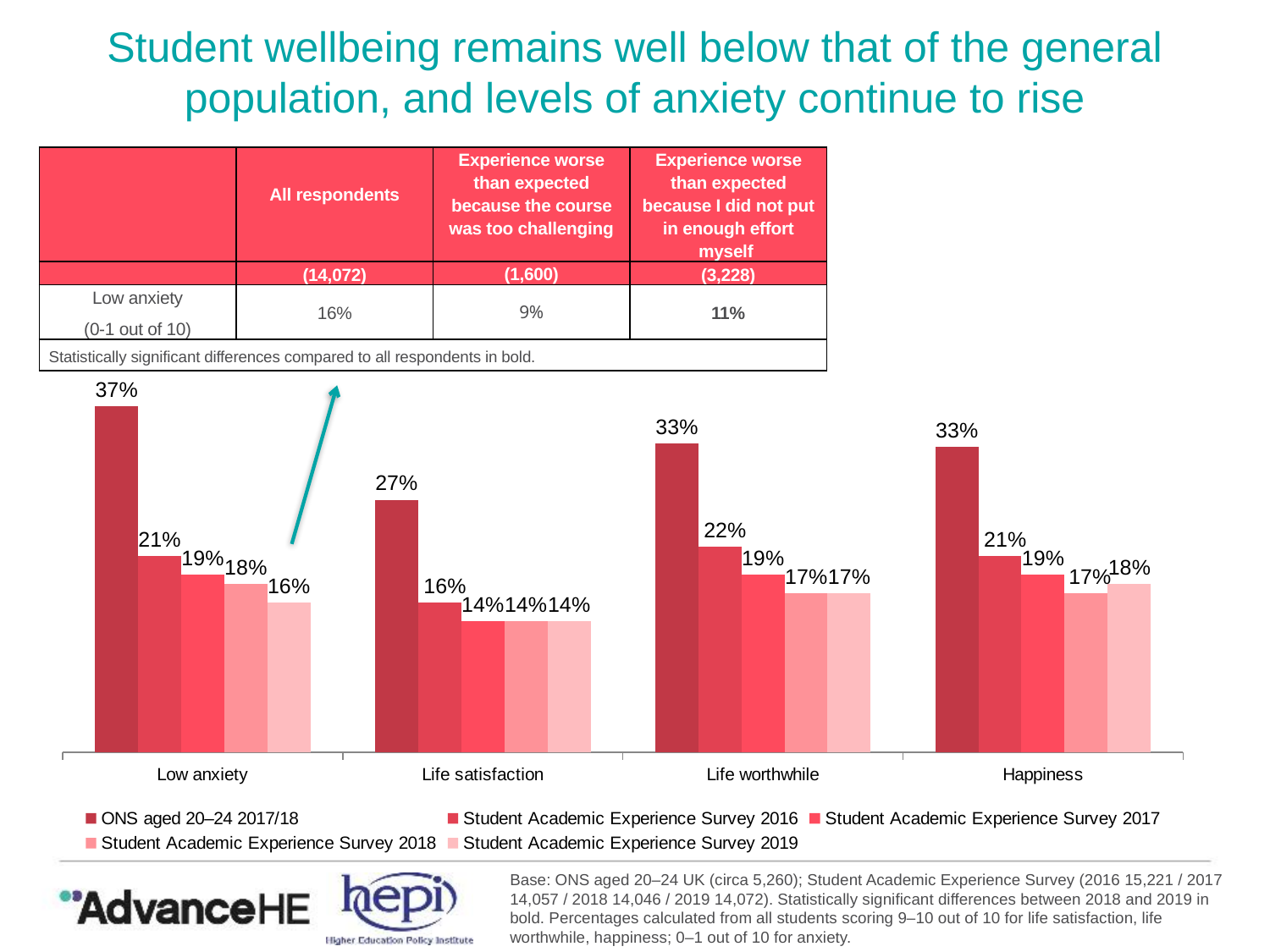
Which category has the highest value for ONS aged 20–24 2017/18? Low anxiety How many series does the chart legend list? 5 What is the difference between the ONS aged 20–24 2017/18 value and the Student Academic Experience Survey 2019 value in the Low anxiety category? 21% What is the value for Student Academic Experience Survey 2019 in the Happiness category? 18% What is the value for Student Academic Experience Survey 2016 in the Life worthwhile category? 22% Which series is shown in the darkest red bars in the chart? ONS aged 20–24 2017/18 What kind of chart is shown on the slide? Bar chart In the Life satisfaction category, which is larger: the value for Student Academic Experience Survey 2016 or for Student Academic Experience Survey 2019? Student Academic Experience Survey 2016 Across the Student Academic Experience Survey series from 2016 to 2019, do the values in the Low anxiety category rise or fall? Fall How many categories are shown on the x axis of the chart? 4 What is the value for ONS aged 20–24 2017/18 in the Low anxiety category? 37% Which category has the lowest value for Student Academic Experience Survey 2019? Life satisfaction